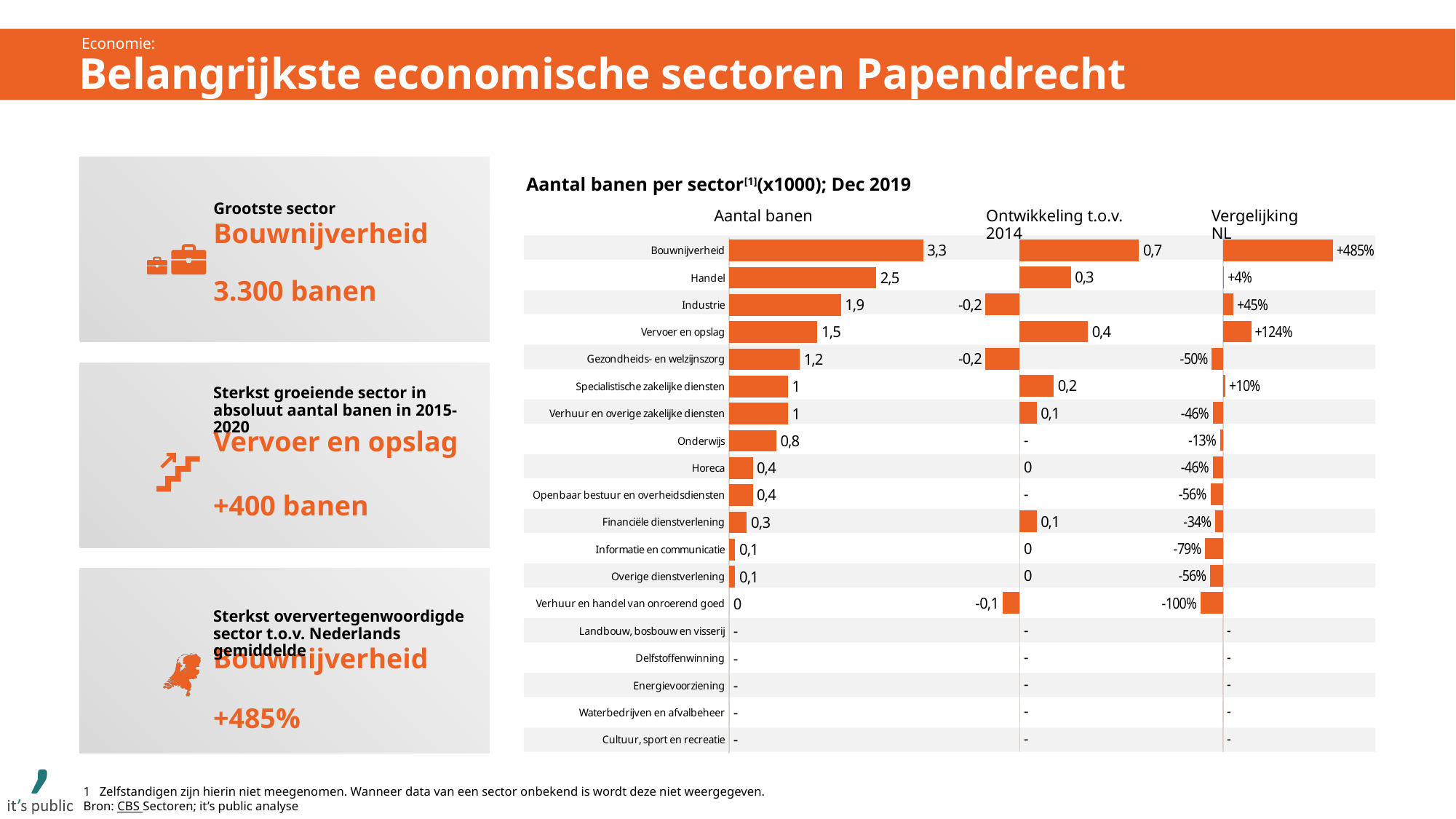
In the 'Ontwikkeling t.o.v. 2014' column, which is larger: Bouwnijverheid or Handel? Bouwnijverheid What is the title of the chart? Aantal banen per sector (x1000); Dec 2019 What kind of chart is used to show the 'Aantal banen' values? Bar chart Which sector has the highest value in the 'Aantal banen' column? Bouwnijverheid In the 'Vergelijking NL' column, what is the value for Bouwnijverheid? +485% In the 'Ontwikkeling t.o.v. 2014' column, what is the value for Vervoer en opslag? 0,4 What is the difference in 'Aantal banen' between Bouwnijverheid and Handel? 0,8 How many sectors are listed in the chart? 19 In the 'Aantal banen' column, which is larger: Industrie or Vervoer en opslag? Industrie In the 'Vergelijking NL' column, what is the value for Informatie en communicatie? -79% In the 'Aantal banen' column, what is the value for Handel? 2,5 Which sector has the lowest value in the 'Vergelijking NL' column? Verhuur en handel van onroerend goed